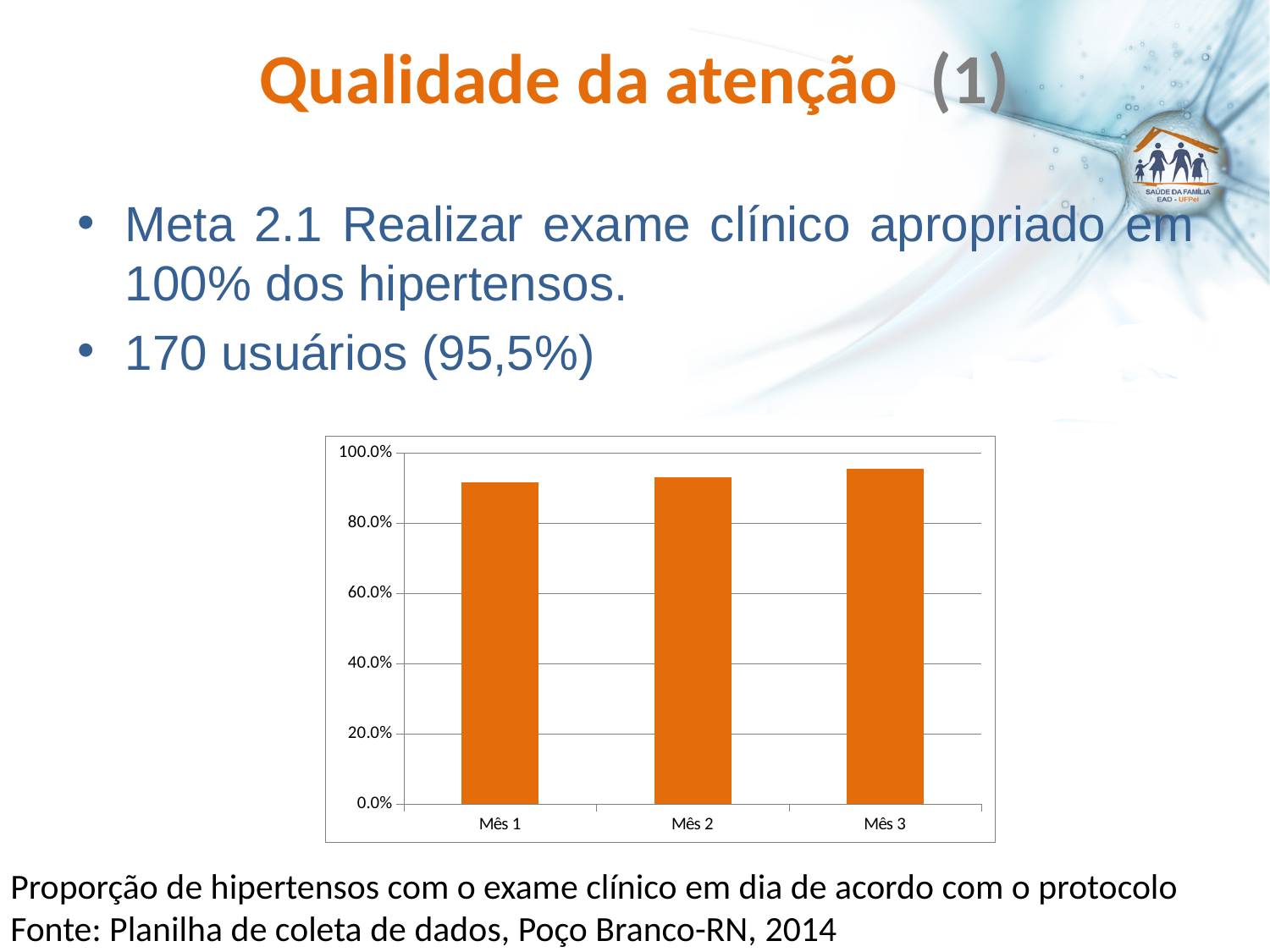
Is the value for Mês 1 greater or less than 80.0%? greater What colour are the bars in the chart? orange Which month has the highest bar on the chart? Mês 3 Do the values rise or fall from Mês 1 to Mês 3? rise How many categories (months) are plotted on the chart? 3 What kind of chart is shown on the slide? bar chart Which is larger, the value for Mês 3 or the value for Mês 1? Mês 3 What is the highest tick label shown on the vertical axis of the chart? 100.0% Is the value for Mês 3 greater or less than 100.0%? less Is the value for Mês 2 greater or less than 80.0%? greater